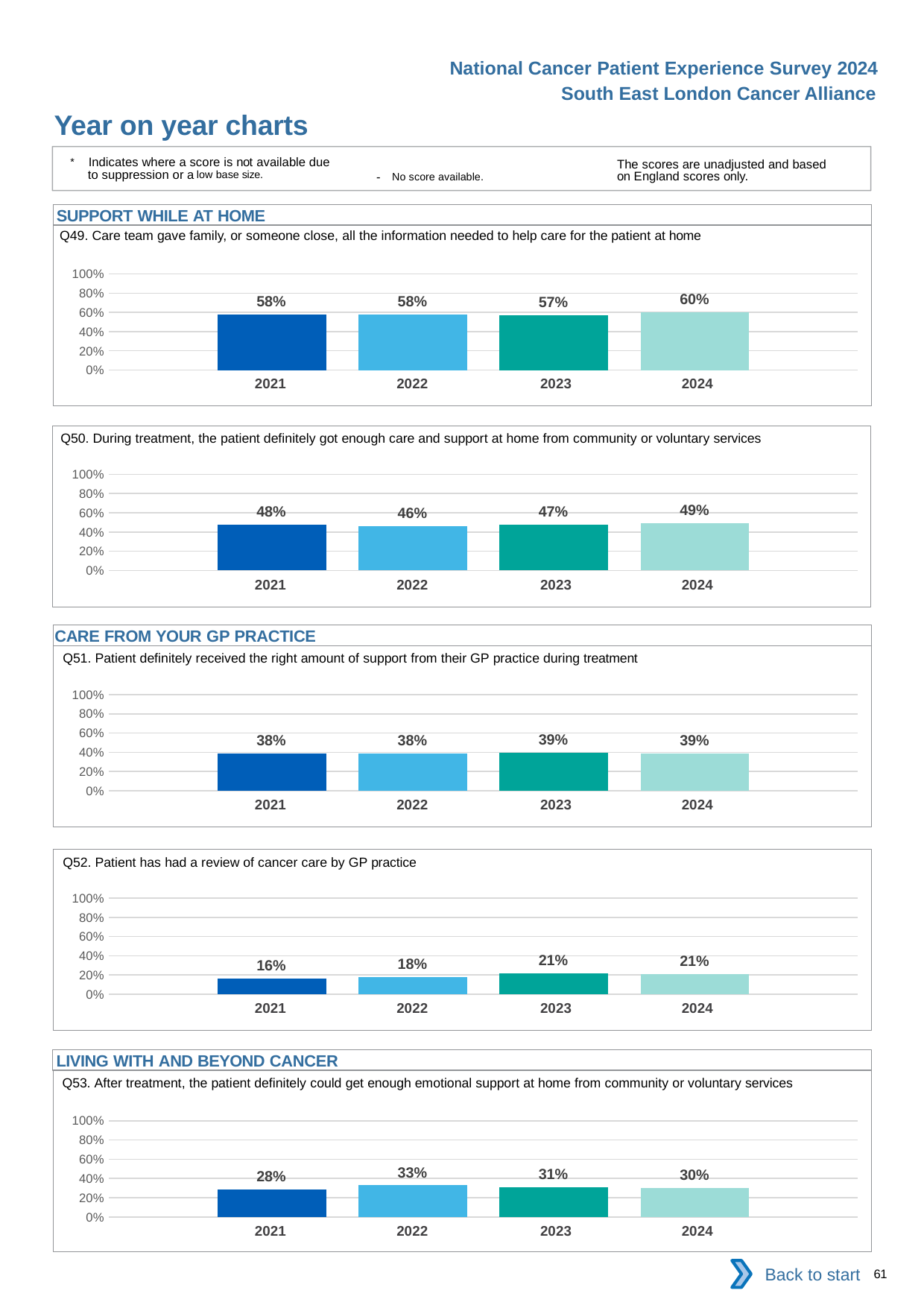
In the Q52 chart, do the values generally rise or fall from 2021 to 2024? rise In the Q53 chart, which year has the highest value? 2022 In the Q50 chart, what is the difference between the 2024 and 2022 values? 3% In the Q49 chart, which year has the highest value? 2024 In the Q50 chart, which year has the lowest value? 2022 In the Q52 chart, what is the difference between the 2023 and 2021 values? 5% In the Q50 chart, what is the value for 2022? 46% In the Q52 chart, what is the value for 2021? 16% In the Q53 chart, is the value for 2022 larger or smaller than the value for 2024? larger How many years are shown on the x axis of the Q53 chart? 4 In the Q49 chart, what is the value for 2024? 60% In the Q51 chart, what is the value for 2021? 38%